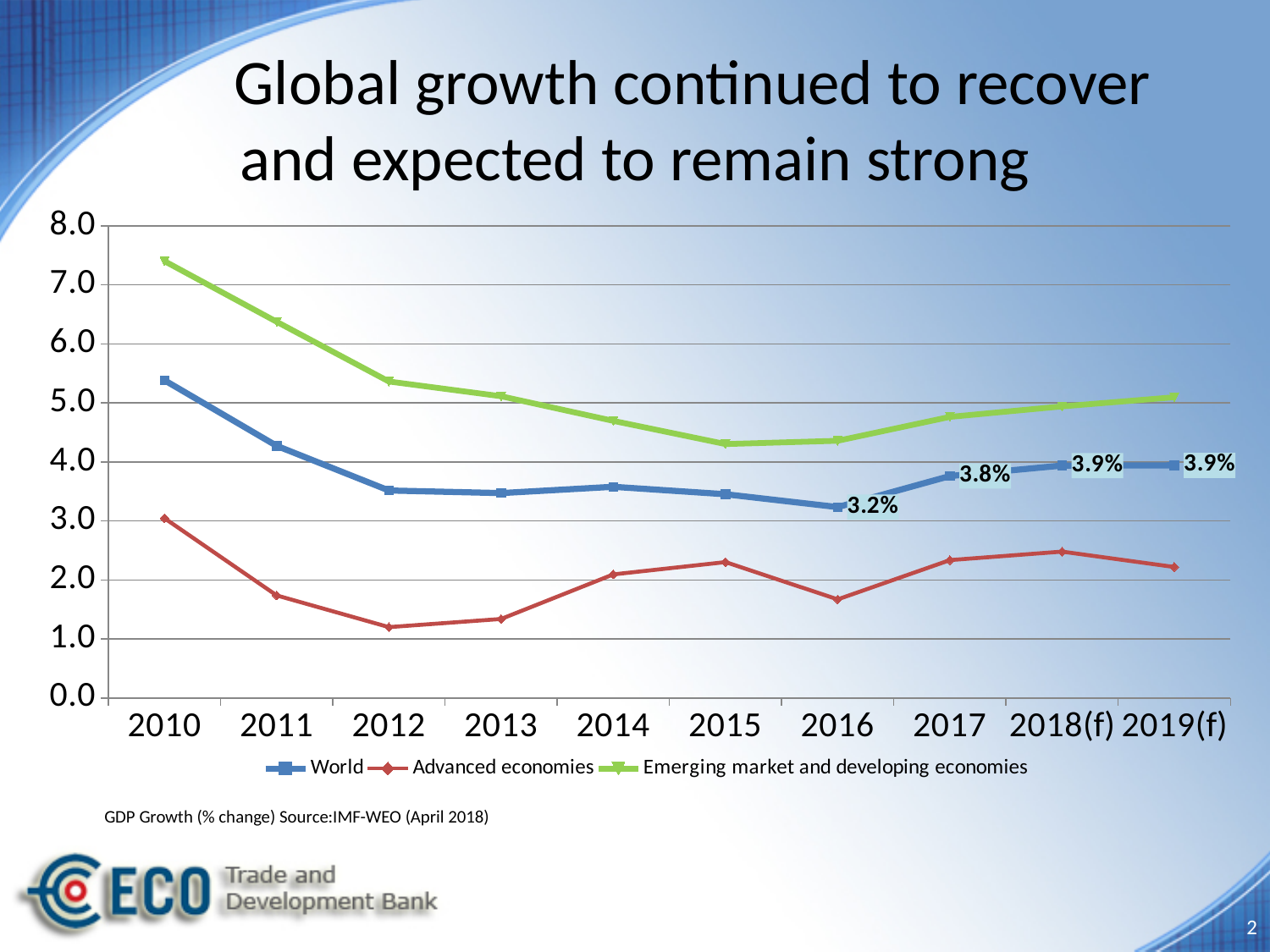
What is the World GDP growth value for 2016? 3.2% How many series does the legend list? 3 By how much does the World value in 2017 exceed the World value in 2016? 0.6% Is the value for Emerging market and developing economies in 2010 greater or less than 7.0? greater Does the Emerging market and developing economies line rise or fall from 2010 to 2015? fall Is the value for World in 2010 greater or less than 5.0? greater Which series has the highest value in 2010? Emerging market and developing economies What kind of chart is shown on the slide? line chart What is the World GDP growth value for 2019(f)? 3.9% How many years are shown on the x axis? 10 Is the value for Advanced economies in 2012 greater or less than 1.5? less What is the World GDP growth value for 2017? 3.8%